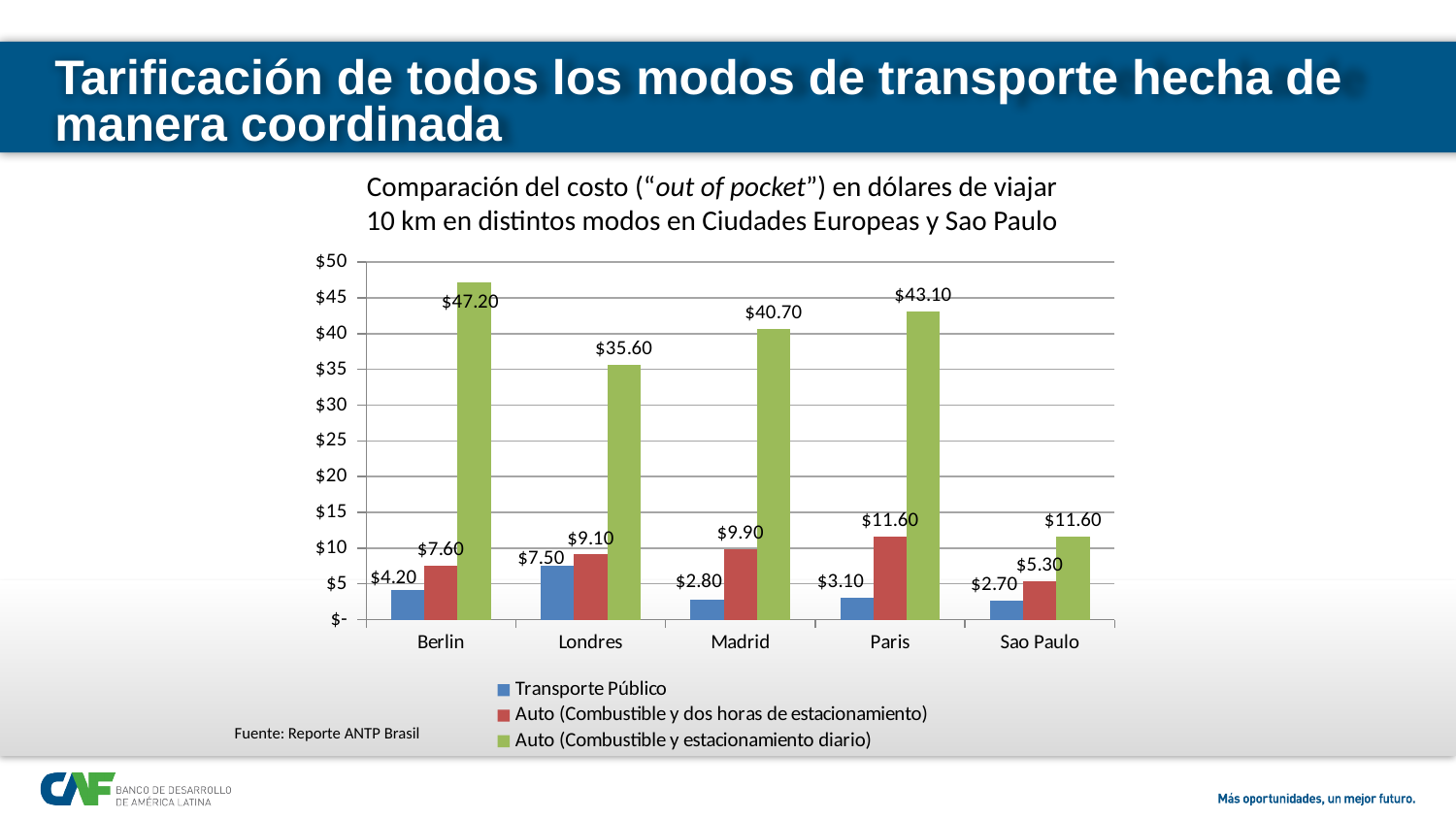
What is the value for Auto (Combustible y dos horas de estacionamiento) in Paris? $11.60 Is the value for Auto (Combustible y estacionamiento diario) in Londres greater or less than $40? less Which city has the lowest value for Transporte Público? Sao Paulo What is the value for Auto (Combustible y estacionamiento diario) in Madrid? $40.70 What is the source cited below the chart? Reporte ANTP Brasil What is the value for Transporte Público in Berlin? $4.20 How many cities are shown on the x axis? 5 How many series does the legend list? 3 What is the difference between the Auto (Combustible y estacionamiento diario) values for Berlin and Sao Paulo? $35.60 Which city has the highest value for Auto (Combustible y estacionamiento diario)? Berlin Which is larger: the Transporte Público value for Londres or for Madrid? Londres What kind of chart is shown on the slide? bar chart